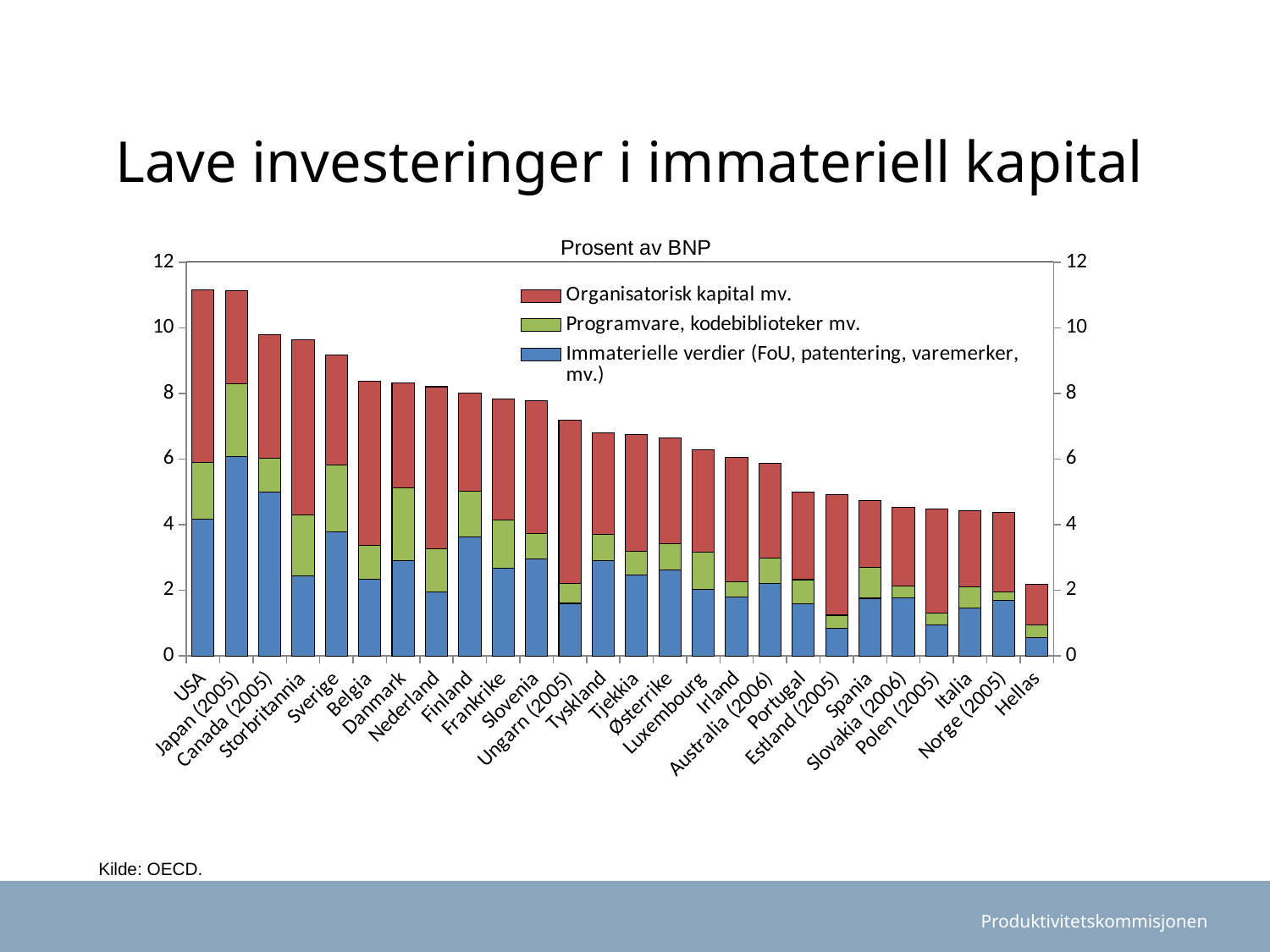
Which has the larger blue segment (Immaterielle verdier), USA or Japan (2005)? Japan (2005) Do the total bar heights rise or fall from left to right along the x axis? Fall How many series does the legend list? 3 What kind of chart is shown on the slide? Stacked bar chart How many countries are shown on the x axis? 26 Is the total value for USA greater or less than 10? greater Is the total value for Hellas greater or less than 4? less Is the total value for Tyskland greater or less than 6? greater Which has the larger total bar, Canada (2005) or Belgia? Canada (2005) What is the title shown above the chart? Prosent av BNP Which country has the lowest total bar? Hellas